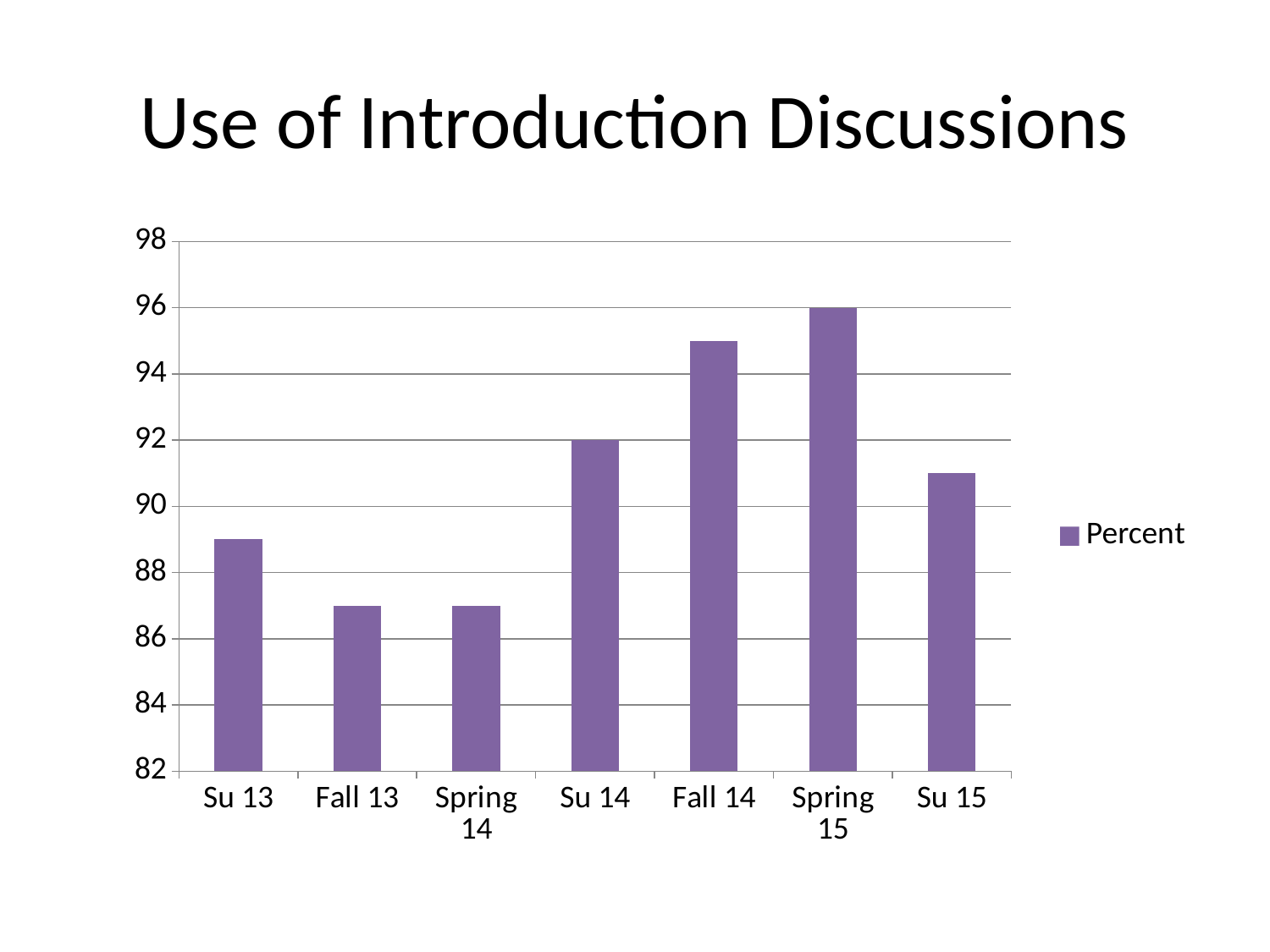
What is the value for Su 14? 92 Which category has the highest value? Spring 15 Is the value for Fall 13 greater or less than 88? less What is the name of the series shown in the legend? Percent Which is larger, the value for Fall 14 or the value for Su 13? Fall 14 What is the title of the chart? Use of Introduction Discussions What is the value for Spring 15? 96 What is the difference between the values for Spring 15 and Su 14? 4 What type of chart is shown on the slide? bar chart How many series does the legend list? 1 Is the value for Fall 14 greater or less than 94? greater How many categories are shown on the x axis? 7